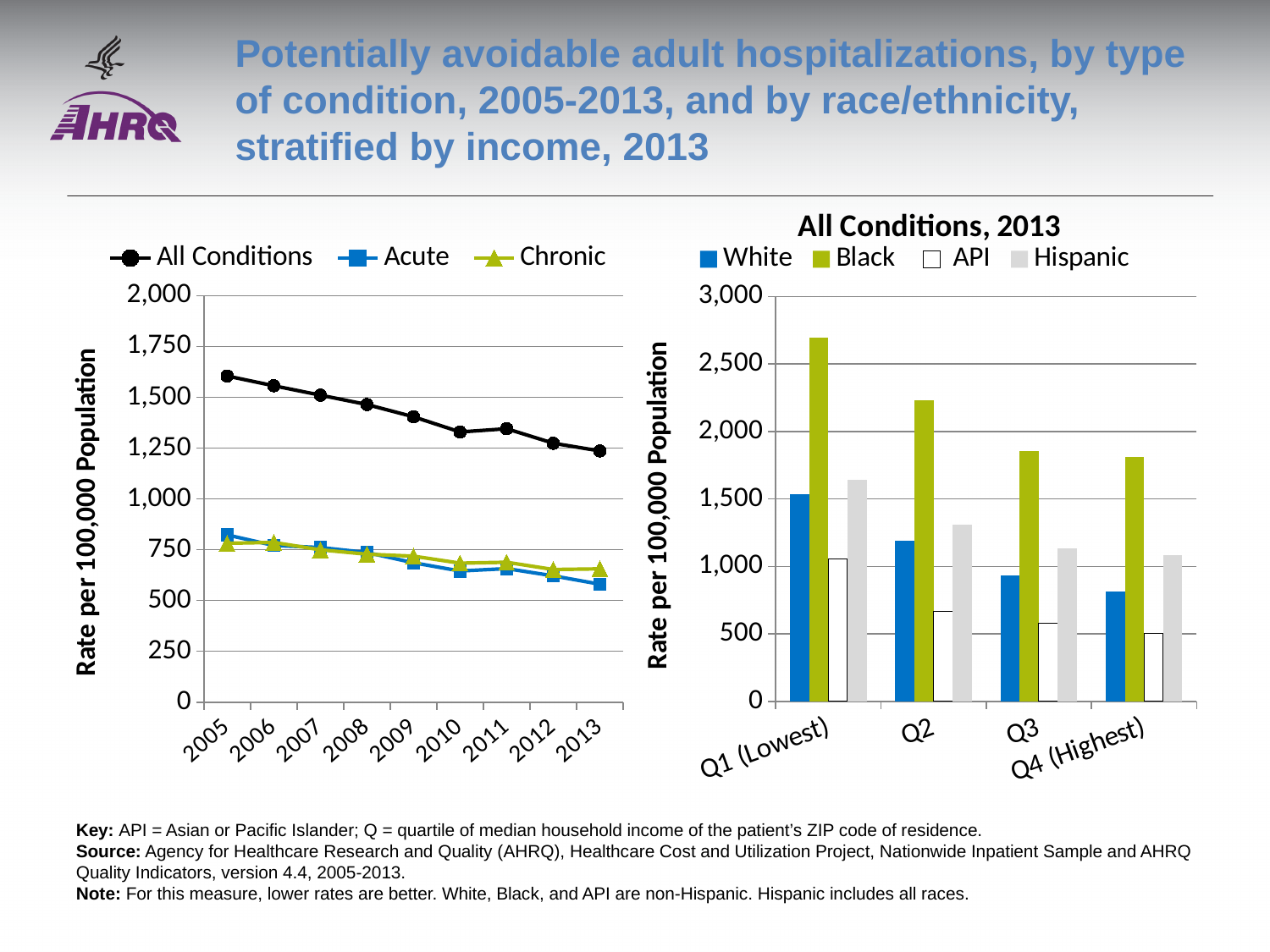
What kind of chart is the 'All Conditions, 2013' chart on the right? bar chart In the 'All Conditions, 2013' chart, which race/ethnicity group has the highest rate in Q1 (Lowest)? Black In the left chart, does the All Conditions rate rise or fall from 2005 to 2013? fall How many years are plotted along the x axis of the left chart? 9 How many series does the legend of the 'All Conditions, 2013' chart list? 4 In the 'All Conditions, 2013' chart, which race/ethnicity group has the lowest rate in Q4 (Highest)? API In the left chart, is the All Conditions value for 2005 greater or less than 1,500? greater What kind of chart is the chart on the left of the slide? line chart How many series does the legend of the left chart list? 3 How many income quartile categories are shown on the x axis of the 'All Conditions, 2013' chart? 4 In the 'All Conditions, 2013' chart, which is larger in Q1 (Lowest): the White bar or the Hispanic bar? Hispanic In the 'All Conditions, 2013' chart, is the value for Black in Q1 (Lowest) greater or less than 2,500? greater